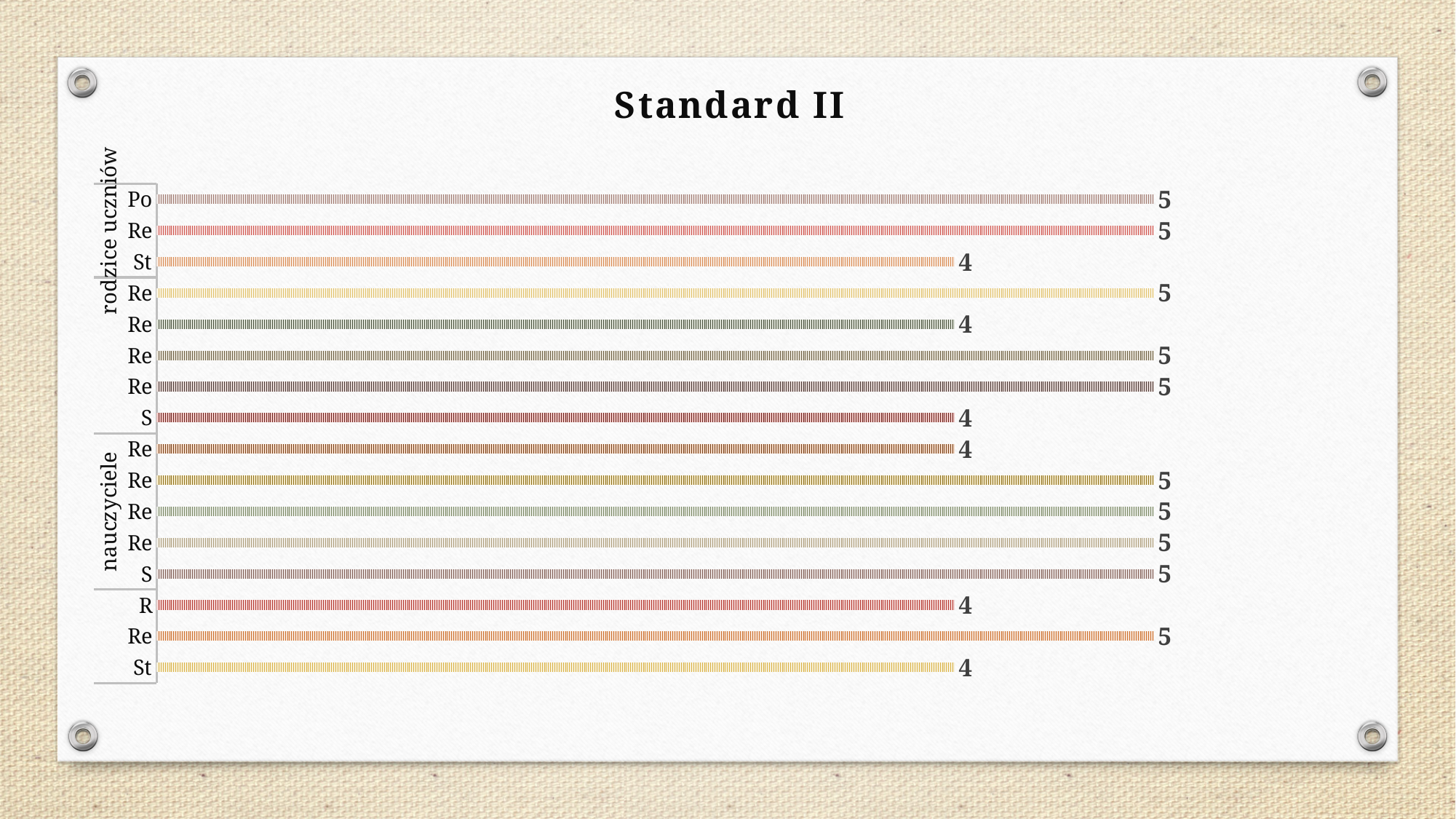
What is the title of the chart? Standard II Which is larger, the value for Po or the value for R? Po What is the difference between the value for Po and the value for R? 1 How many bars belong to the 'rodzice uczniów' group? 3 What is the value of the bar labelled Po? 5 What kind of chart is shown on the slide? bar chart What is the value of the first bar in the 'nauczyciele' group? 4 What is the highest value shown on any bar? 5 What is the lowest value shown on any bar? 4 How many bars does the chart contain? 16 What is the value of the bar labelled R? 4 What is the value of the last (bottom) bar, labelled St? 4